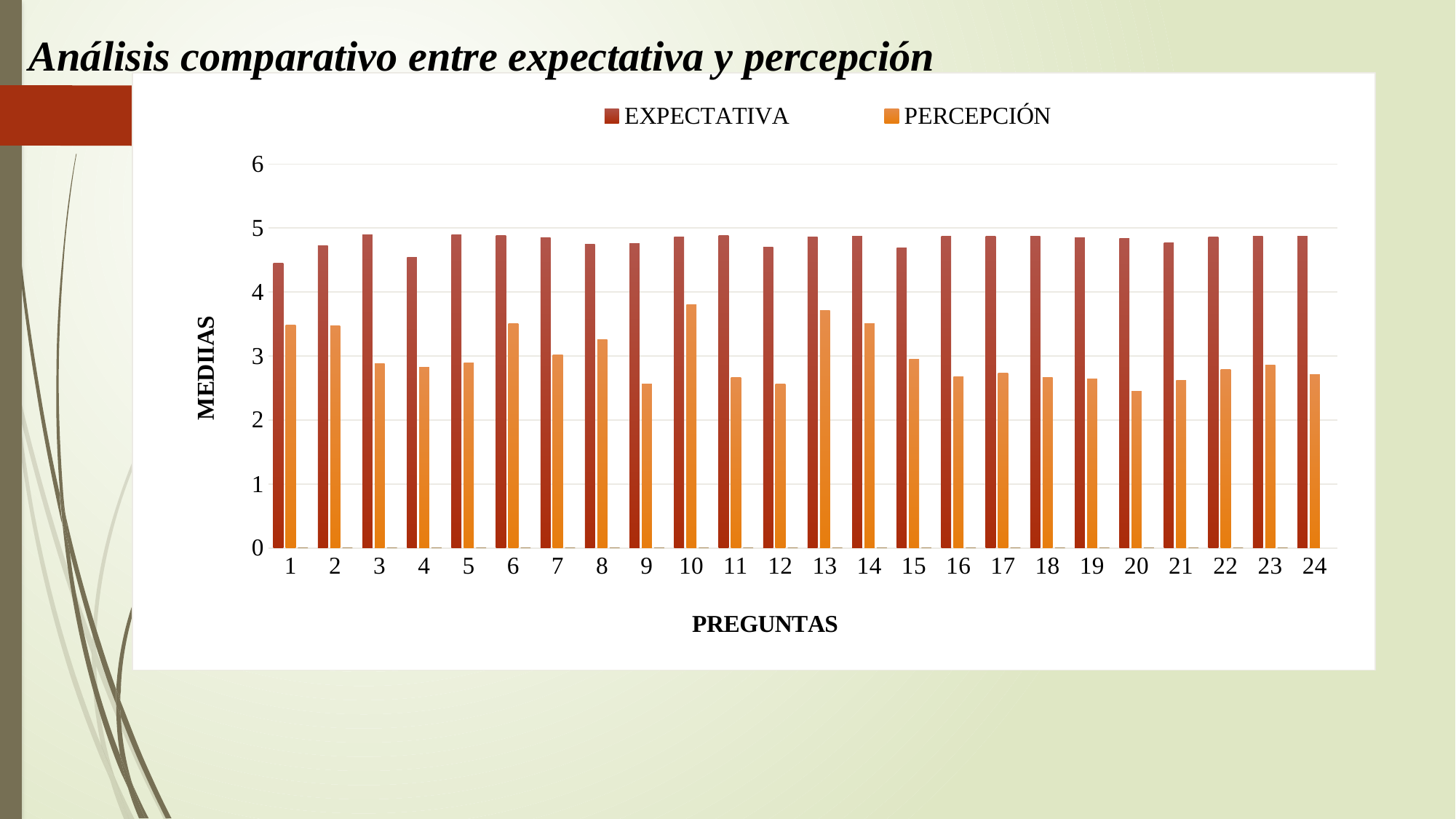
Is the PERCEPCIÓN value for question 10 greater or less than 3? greater What kind of chart is shown on the slide? bar chart What is the title of the vertical axis? MEDIIAS Is the PERCEPCIÓN value for question 20 greater or less than 3? less How many questions (preguntas) are shown on the x axis? 24 For question 5, which is larger: EXPECTATIVA or PERCEPCIÓN? EXPECTATIVA Which series is shown in the darker red-brown colour? EXPECTATIVA Is the EXPECTATIVA value for question 3 greater or less than 4? greater Which question has the highest PERCEPCIÓN value? 10 How many series does the legend list? 2